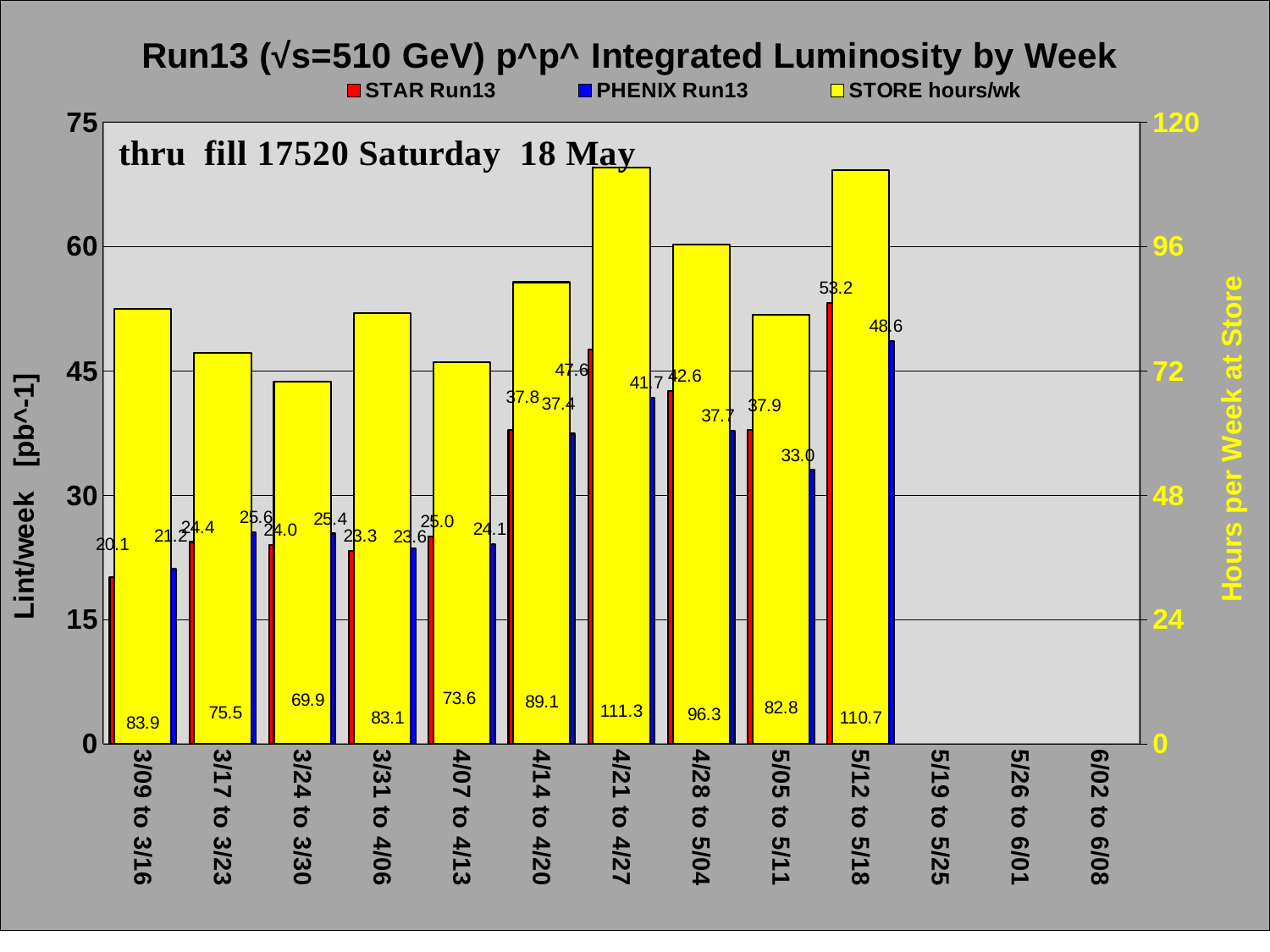
Which week has the highest STAR Run13 value? 5/12 to 5/18 Which week has the lowest STORE hours/wk value? 3/24 to 3/30 Which week has the highest STORE hours/wk value? 4/21 to 4/27 What is the difference between the STAR Run13 and PHENIX Run13 values for the week 5/12 to 5/18? 4.6 How many series does the legend list? 3 How many week categories are shown on the x axis? 13 What is the PHENIX Run13 value for the week 3/09 to 3/16? 21.2 What is the STORE hours/wk value for the week 4/21 to 4/27? 111.3 For the week 4/21 to 4/27, which is larger: the STAR Run13 value or the PHENIX Run13 value? STAR Run13 What is the label of the right-hand vertical axis? Hours per Week at Store What is the STAR Run13 value for the week 5/12 to 5/18? 53.2 What kind of chart is shown on the slide? Bar chart